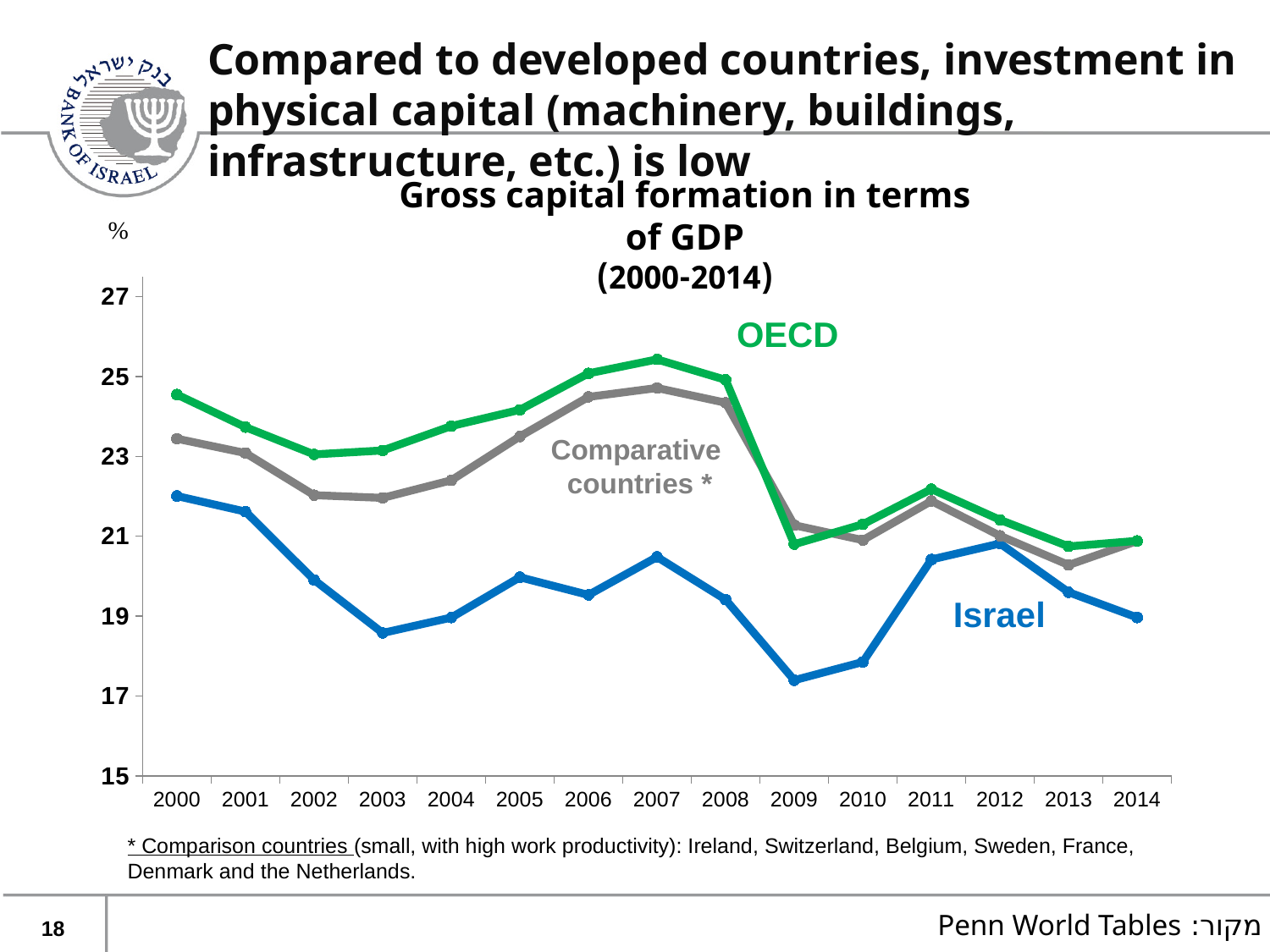
What kind of chart is shown on the slide? line chart Is the value for Israel in 2000 greater or less than 21? greater Is the value for Israel in 2009 greater or less than 19? less Is the value for Comparative countries in 2003 greater or less than 23? less In which year does the Israel line reach its lowest value? 2009 How many years are plotted along the x axis of the chart? 15 How many series (lines) are plotted in the chart? 3 In 2009, which is larger: the value for OECD or the value for Israel? OECD In which year does the OECD line reach its highest value? 2007 Does the Israel line rise or fall from 2000 to 2003? fall Which series is drawn in green? OECD